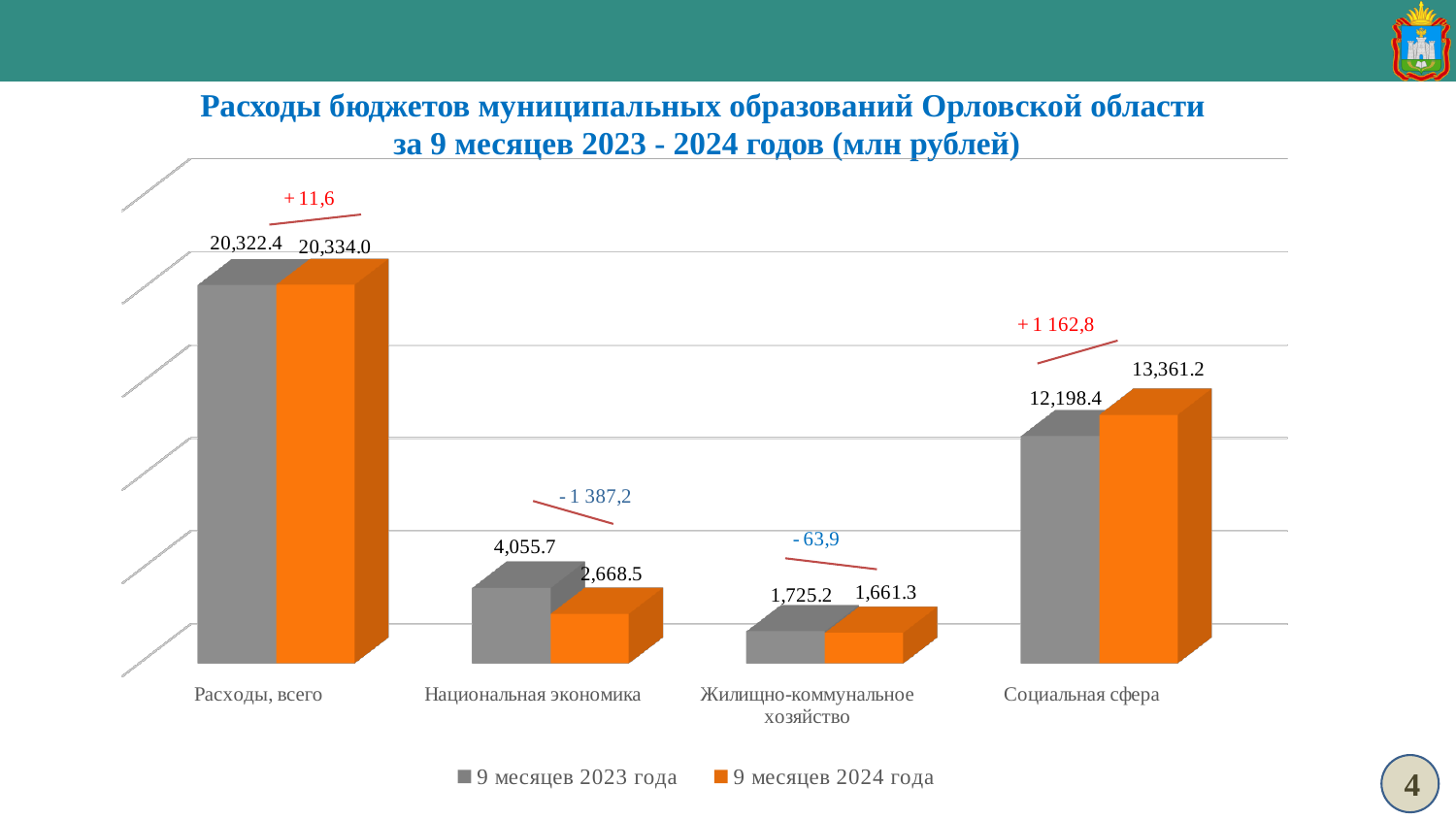
What kind of chart is shown on the slide? Bar chart Which category has the lowest value in the 9 месяцев 2024 года series? Жилищно-коммунальное хозяйство What is the value for Жилищно-коммунальное хозяйство in the 9 месяцев 2024 года series? 1,661.3 How many series does the legend list? 2 Which is larger for Социальная сфера: the 9 месяцев 2023 года value or the 9 месяцев 2024 года value? 9 месяцев 2024 года What change is annotated above the bars for Социальная сфера? + 1 162,8 Which category has the highest value in the 9 месяцев 2023 года series? Расходы, всего What is the value for Национальная экономика in the 9 месяцев 2023 года series? 4,055.7 How many categories are shown on the x axis? 4 What is the value for Социальная сфера in the 9 месяцев 2024 года series? 13,361.2 What is the value for Расходы, всего in the 9 месяцев 2023 года series? 20,322.4 What is the difference between the 9 месяцев 2023 года and 9 месяцев 2024 года values for Национальная экономика? 1,387.2